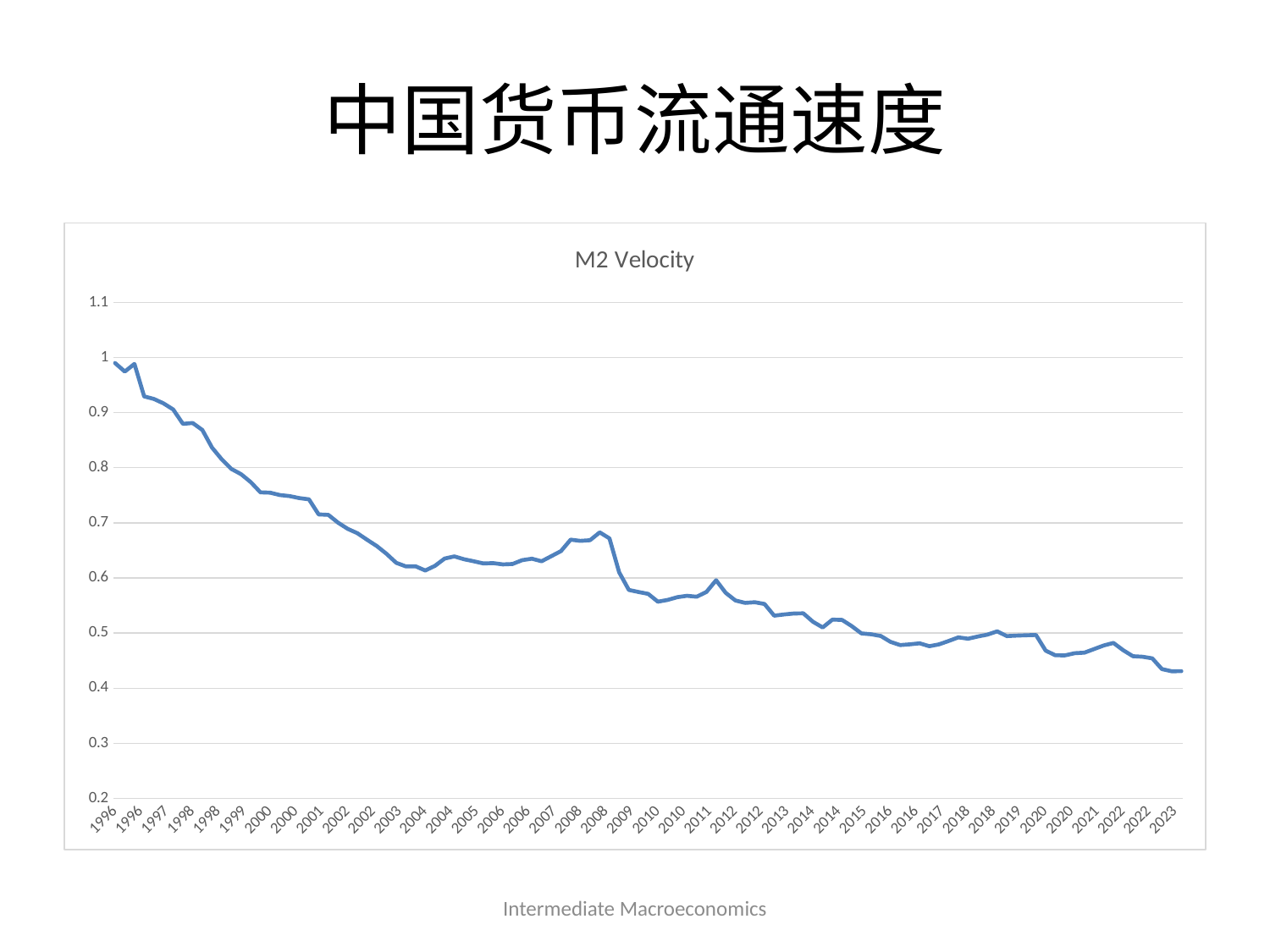
Is the peak value around 2008 greater or less than 0.6? greater In which year is M2 velocity at its lowest? 2023 What is the highest value shown on the vertical axis? 1.1 Is the value for 1996 greater or less than 0.9? greater What kind of chart is shown on the slide? line chart In which year is M2 velocity at its highest? 1996 How many lines are plotted on the chart? 1 Does M2 velocity generally rise or fall from 1996 to 2023? fall Is the value for 2023 greater or less than 0.5? less Which is larger, the value for 1998 or the value for 2010? 1998 What is the title of the chart? M2 Velocity